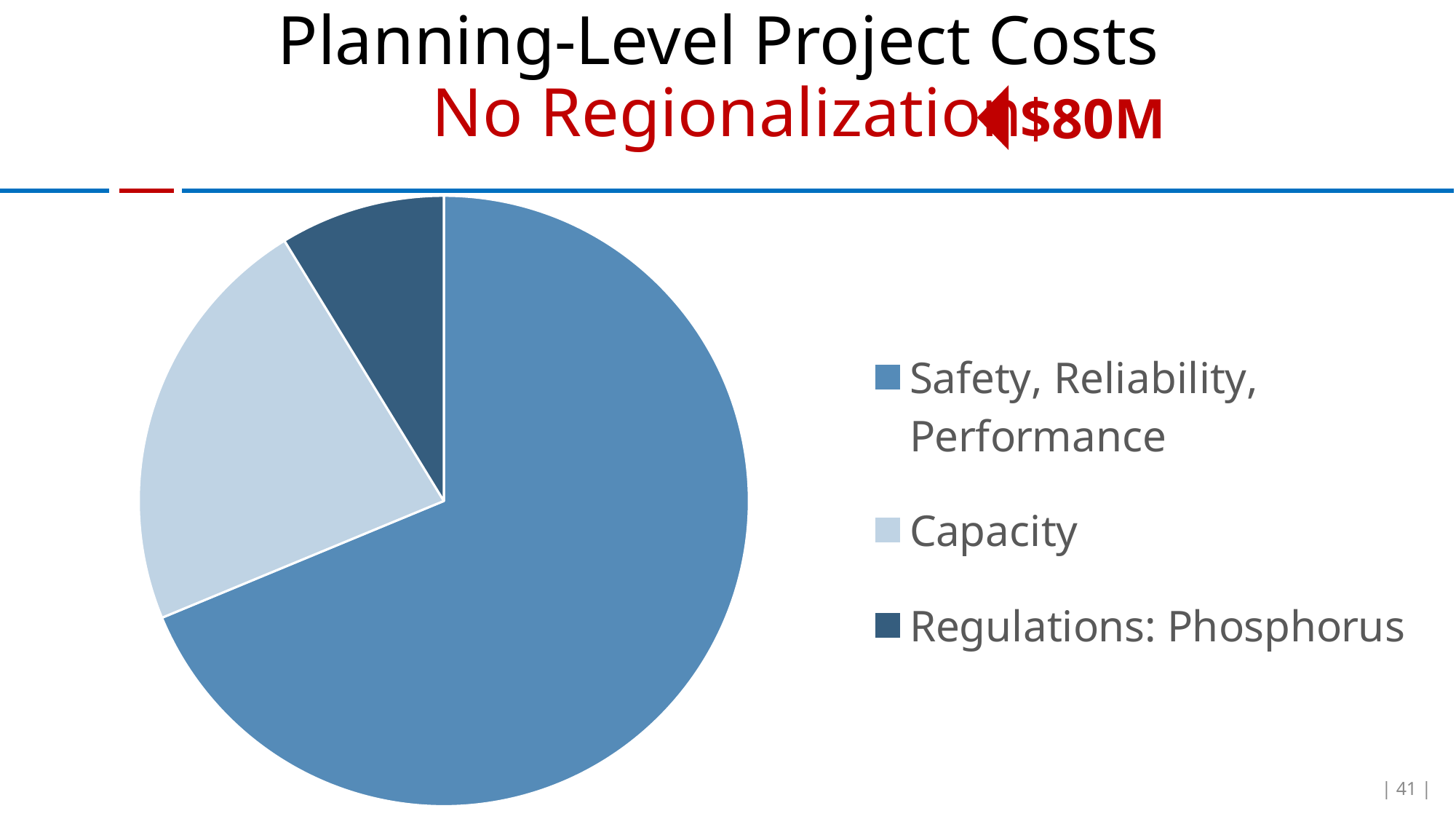
Which category has the largest slice of the pie chart? Safety, Reliability, Performance How many entries does the legend of the pie chart list? 3 Which slice is larger, Capacity or Regulations: Phosphorus? Capacity Does the Safety, Reliability, Performance slice take up more or less than half of the pie? More Which slice is larger, Safety, Reliability, Performance or Capacity? Safety, Reliability, Performance Which legend entry is shown with the darkest blue colour? Regulations: Phosphorus What kind of chart is shown on the slide? Pie chart How many slices does the pie chart have? 3 What is the main title of the slide containing the pie chart? Planning-Level Project Costs Which category has the smallest slice of the pie chart? Regulations: Phosphorus